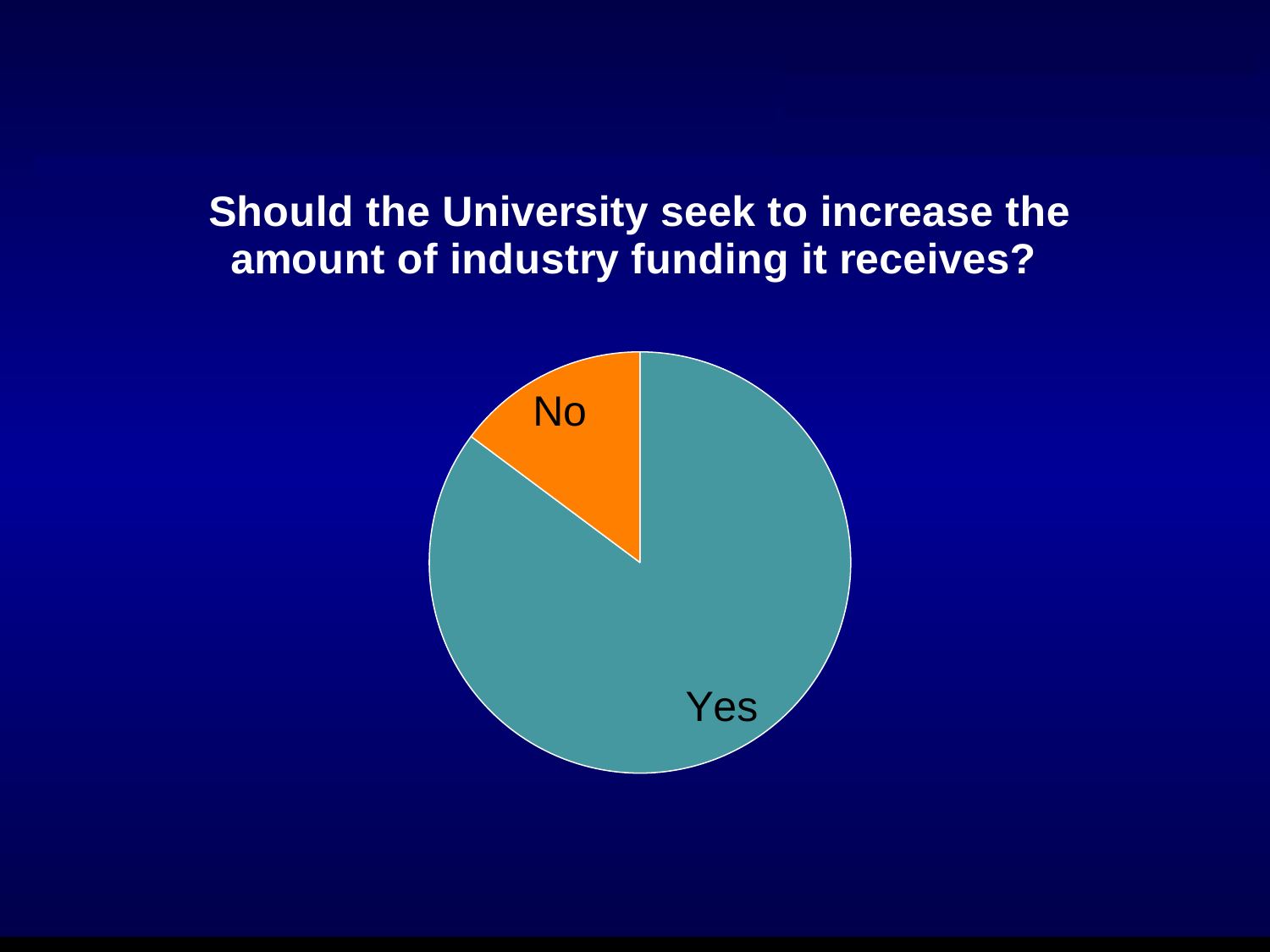
Which slice of the pie chart is the smallest? No Which slice of the pie chart is the largest? Yes What colour is the No slice of the pie chart? orange What question is the pie chart answering, according to the slide title? Should the University seek to increase the amount of industry funding it receives? How many slices does the pie chart have? 2 Which is larger in the pie chart, the Yes slice or the No slice? Yes What kind of chart is shown on the slide? pie chart What are the labels of the two slices in the pie chart? Yes and No